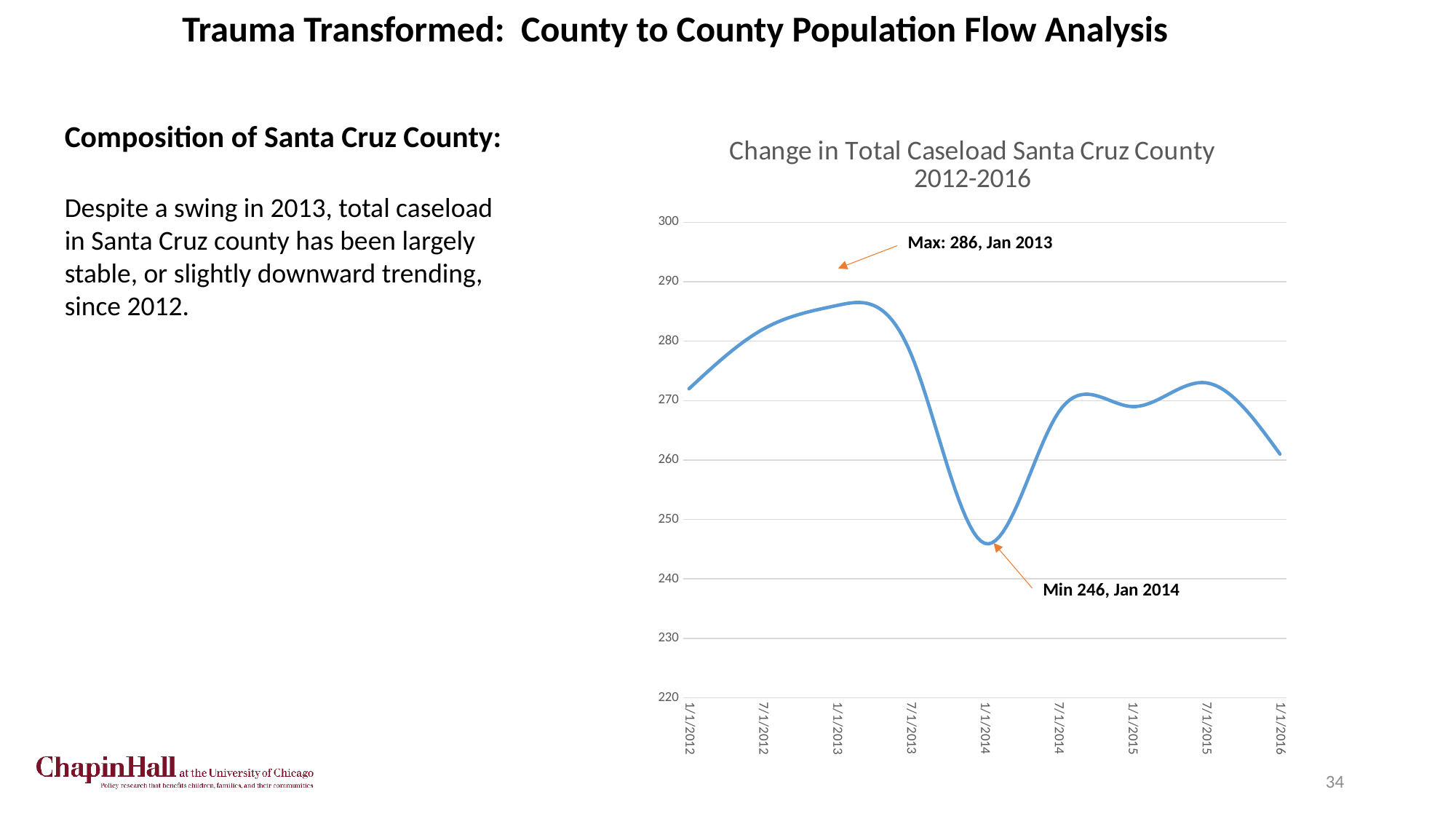
How many date labels are shown on the x axis? 9 In which month does the chart mark the maximum caseload? Jan 2013 Does the caseload rise or fall between 1/1/2012 and 1/1/2013? rise What kind of chart is shown on the slide? line chart Does the caseload rise or fall between 1/1/2013 and 1/1/2014? fall Is the value for 1/1/2016 greater or less than 270? less What is the difference between the marked maximum (Jan 2013) and the marked minimum (Jan 2014) caseload? 40 What is the maximum total caseload value marked on the chart? 286 What is the minimum total caseload value marked on the chart? 246 Is the value for 7/1/2012 greater or less than 280? greater In which month does the chart mark the minimum caseload? Jan 2014 What is the title of the chart? Change in Total Caseload Santa Cruz County 2012-2016